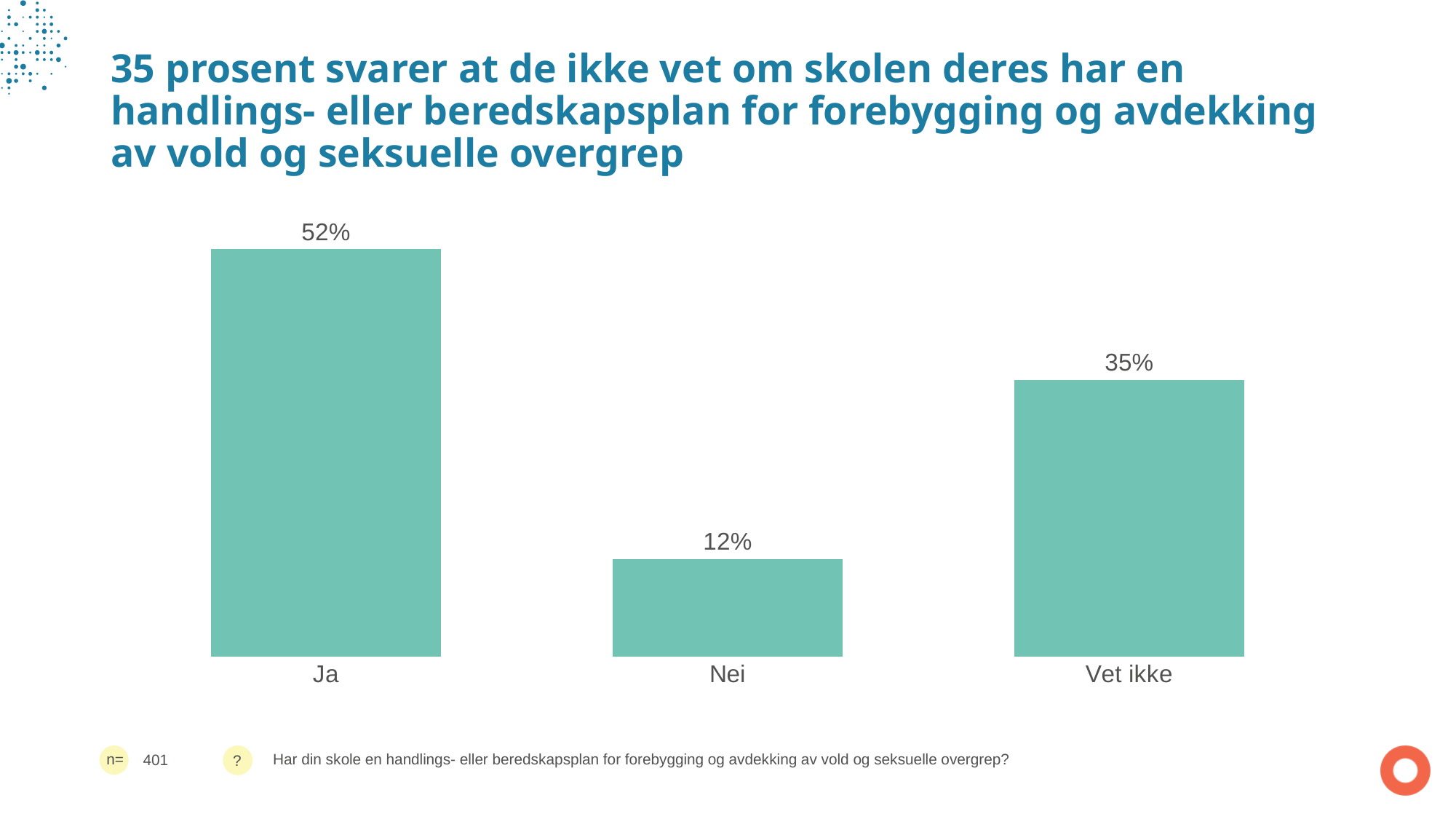
Which category has the highest value? Ja What kind of chart is shown on the slide? Bar chart What is the difference between the values for "Vet ikke" and "Nei"? 23% What is the difference between the values for "Ja" and "Vet ikke"? 17% Which is larger, the value for "Nei" or the value for "Vet ikke"? Vet ikke How many categories are shown in the chart? 3 What is the value for "Vet ikke"? 35% Which category has the lowest value? Nei What colour are the bars in the chart? Teal (green) What is the value for "Nei"? 12% What is the sample size (n) shown at the bottom of the slide? 401 What is the value for "Ja"? 52%